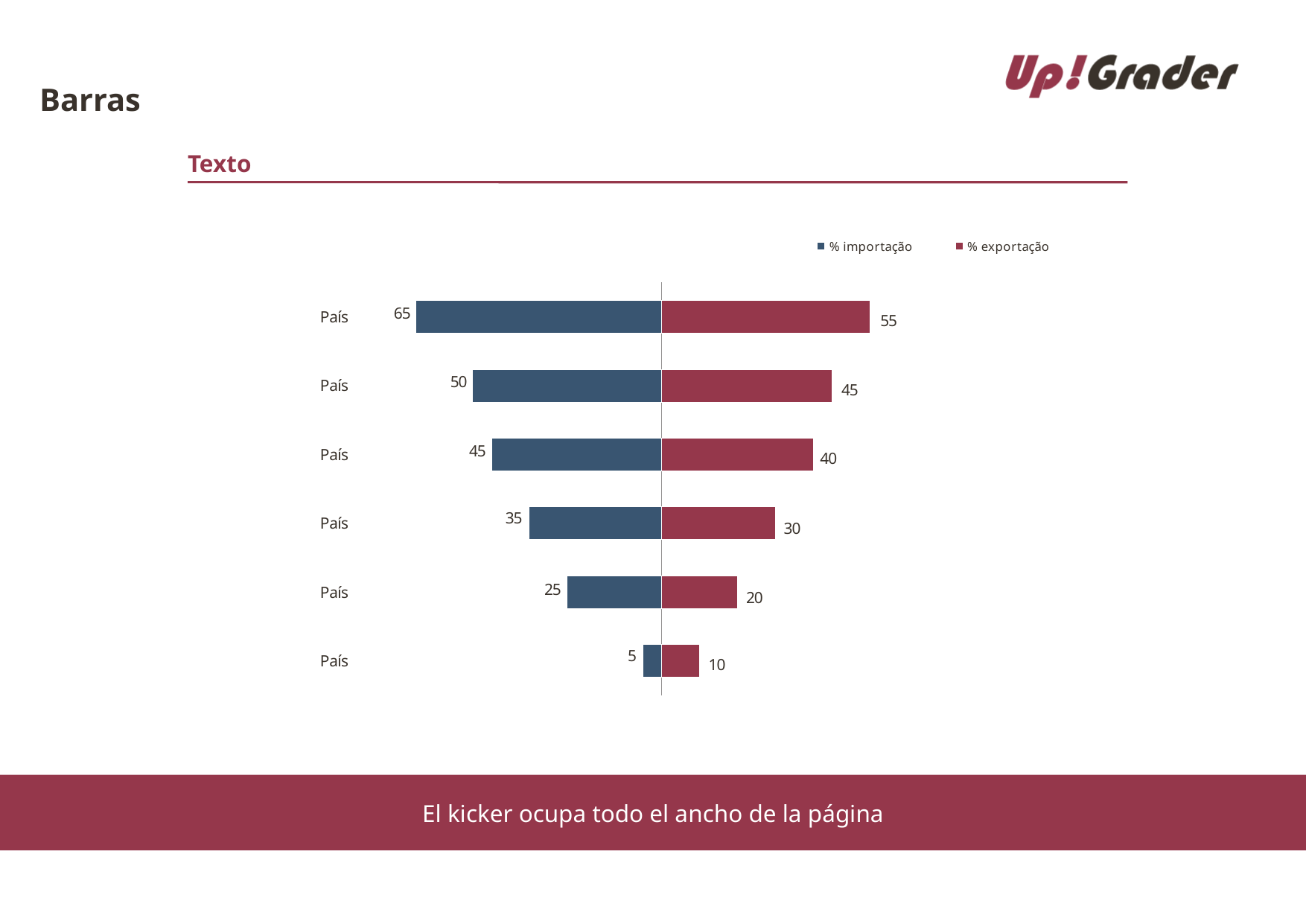
What is the difference between the % importação and % exportação values in the top row? 10 Which row has the highest % importação value? the top row (65) What is the % exportação value for the bottom row of the chart? 10 How many series does the chart legend list? 2 How many category rows (bars per series) does the chart show? 6 What is the % importação value for the top row of the chart? 65 Do the % exportação values rise or fall going from the top row to the bottom row? fall What are the two series named in the chart legend? % importação and % exportação In the bottom row, which is larger: % importação or % exportação? % exportação What is the % exportação value for the top row of the chart? 55 What kind of chart is shown on the slide? bar chart What is the % importação value for the fourth row from the top? 35